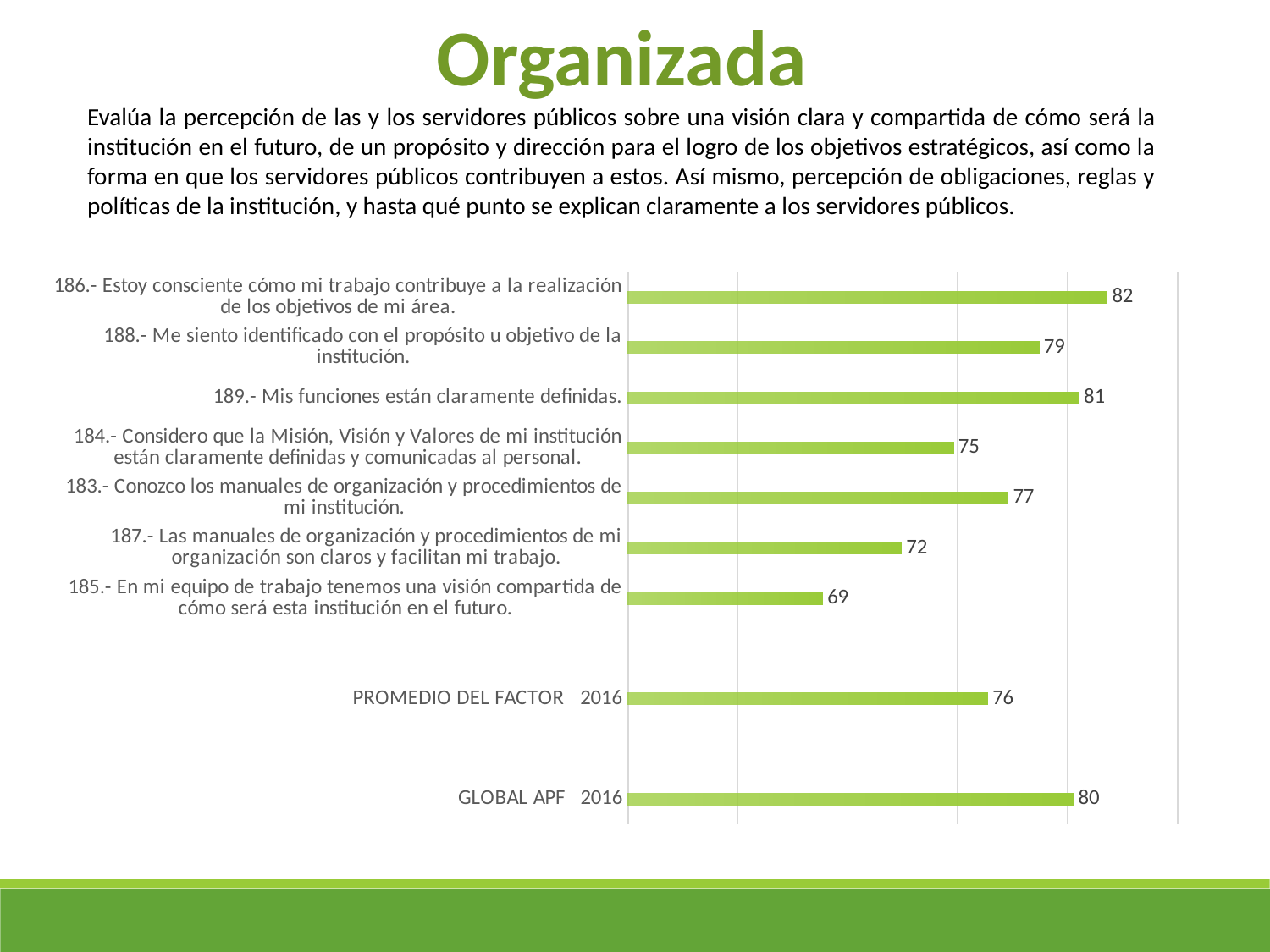
What is the difference between the value for item 186 and the value for item 185? 13 Which is larger, the value for item 189 or the value for item 184? 189.- Mis funciones están claramente definidas. What is the difference between GLOBAL APF 2016 and PROMEDIO DEL FACTOR 2016? 4 What is the value for GLOBAL APF 2016? 80 What is the value for PROMEDIO DEL FACTOR 2016? 76 What is the value for item 186 (Estoy consciente cómo mi trabajo contribuye a la realización de los objetivos de mi área)? 82 How many bars are plotted in the chart? 9 Which item has the lowest value? 185.- En mi equipo de trabajo tenemos una visión compartida de cómo será esta institución en el futuro. Which item has the highest value? 186.- Estoy consciente cómo mi trabajo contribuye a la realización de los objetivos de mi área. What is the title of the slide? Organizada What is the value for item 185 (En mi equipo de trabajo tenemos una visión compartida de cómo será esta institución en el futuro)? 69 What kind of chart is shown on the slide? Bar chart